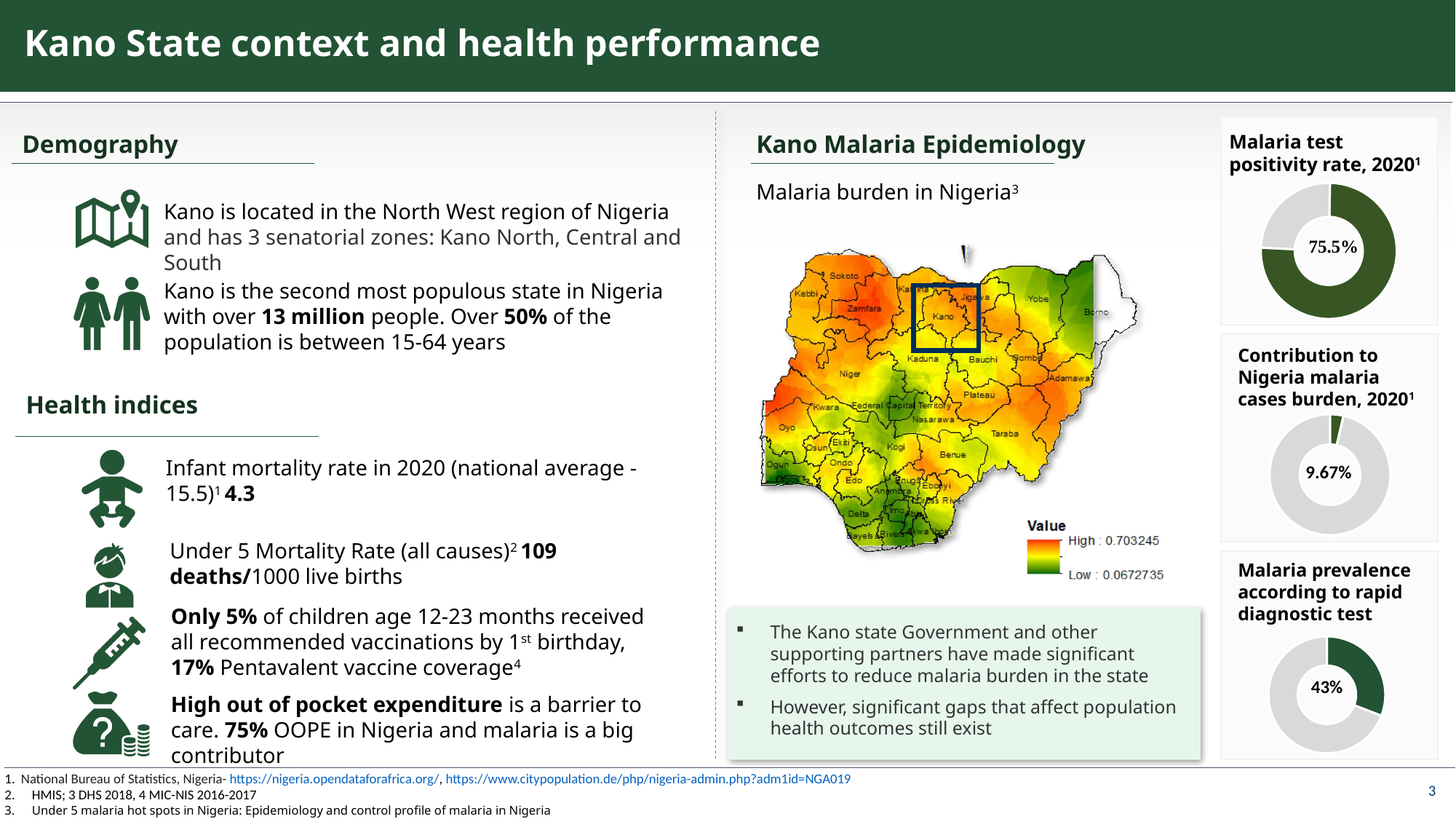
In the 'Malaria prevalence according to rapid diagnostic test' donut chart, is the dark green segment greater or less than half of the ring? less On the Nigeria malaria burden map, what is the 'Low' value shown in the legend? 0.0672735 What value is shown in the centre of the 'Contribution to Nigeria malaria cases burden, 2020' donut chart? 9.67% What value is shown in the centre of the 'Malaria prevalence according to rapid diagnostic test' donut chart? 43% Of the three donut charts on the right of the slide, which shows the lowest value? Contribution to Nigeria malaria cases burden, 2020 What is the difference between the malaria test positivity rate (75.5%) and the malaria prevalence according to rapid diagnostic test (43%)? 32.5% What value is shown in the centre of the 'Malaria test positivity rate, 2020' donut chart? 75.5% Which is larger: the malaria test positivity rate (2020) or the malaria prevalence according to rapid diagnostic test? Malaria test positivity rate (2020) Of the three donut charts on the right of the slide, which shows the highest value? Malaria test positivity rate, 2020 What kind of chart is used to show the malaria test positivity rate on the right of the slide? Donut chart On the Nigeria malaria burden map, what is the 'High' value shown in the legend? 0.703245 How many donut charts are shown on the right side of the slide? 3